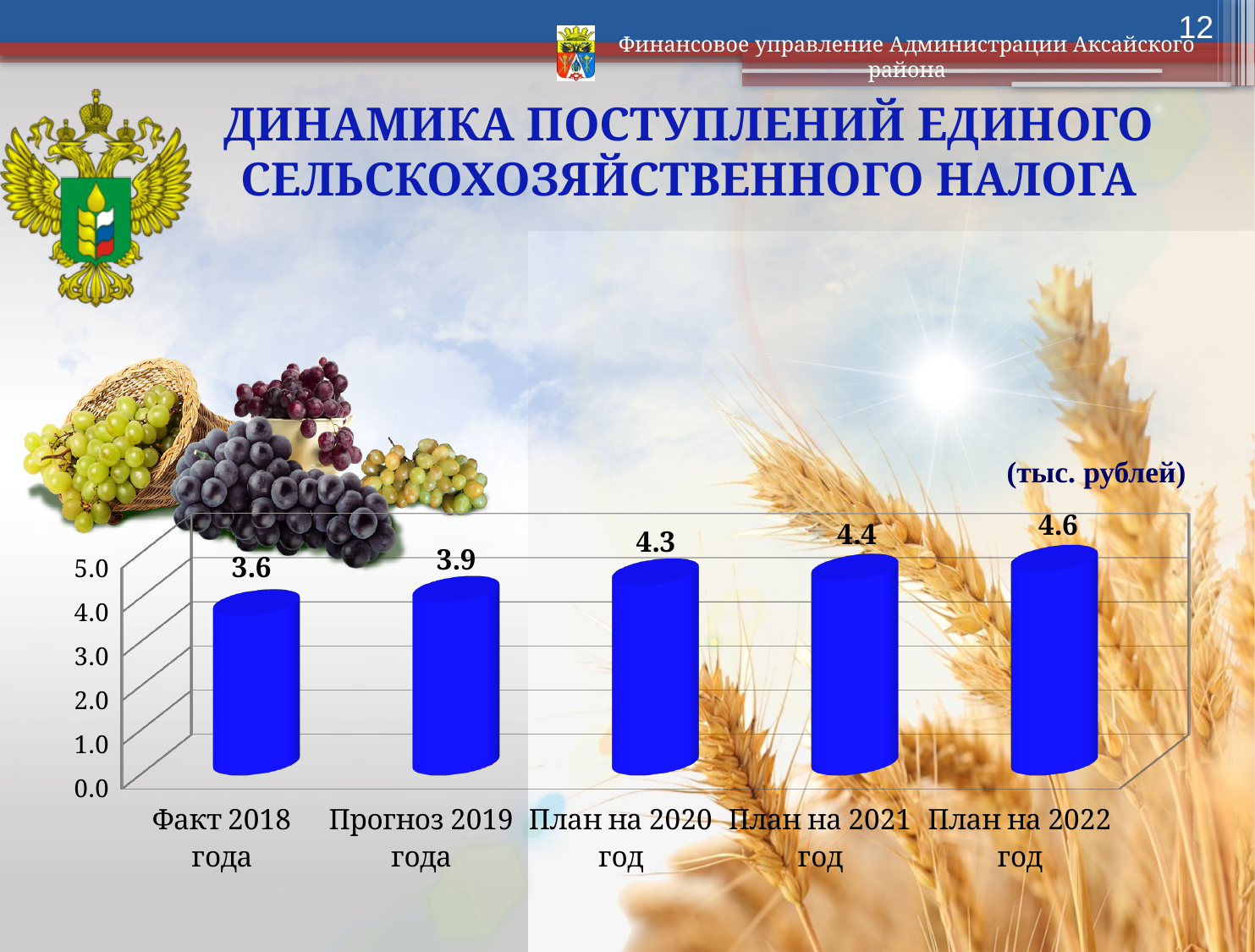
Is the value for План на 2020 год greater or less than 4.0? greater What is the value for Факт 2018 года? 3.6 What is the value for План на 2022 год? 4.6 What is the value for План на 2020 год? 4.3 Which is larger, the value for План на 2021 год or the value for Прогноз 2019 года? План на 2021 год How many categories are shown on the x axis? 5 Which category has the lowest value? Факт 2018 года What is the difference between the values for План на 2022 год and Факт 2018 года? 1.0 What kind of chart is shown on the slide? bar chart Do the values rise or fall from Факт 2018 года to План на 2022 год? rise Which category has the highest value? План на 2022 год What is the difference between the values for Прогноз 2019 года and Факт 2018 года? 0.3